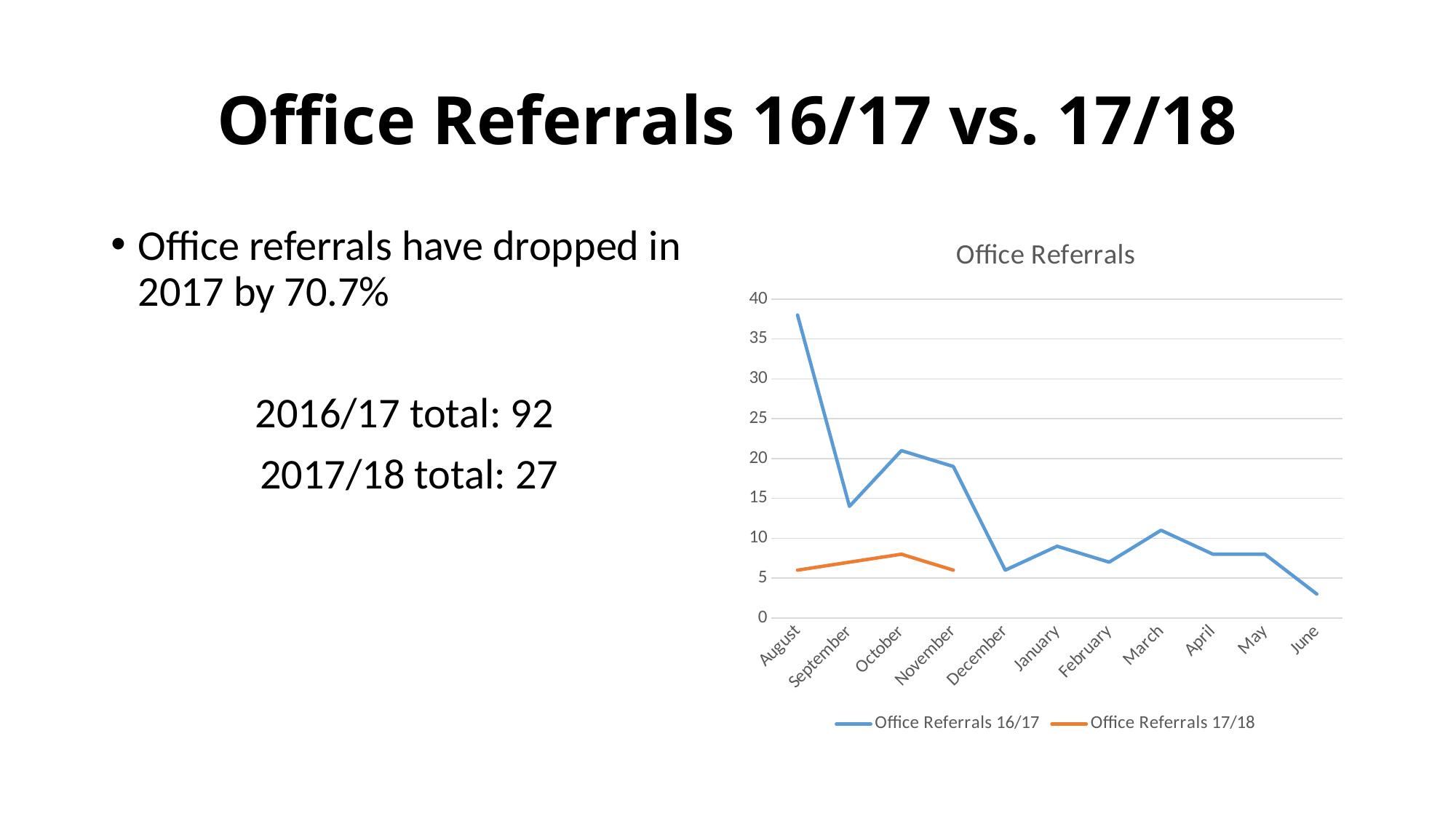
Is the value for June in the Office Referrals 16/17 series greater or less than 5? less In which month is the Office Referrals 16/17 series at its lowest? June How many series does the chart's legend list? 2 In which month is the Office Referrals 16/17 series at its highest? August Does the Office Referrals 16/17 series generally rise or fall from August to June? Fall Is the value for October in the Office Referrals 17/18 series greater or less than 10? less Is the value for August in the Office Referrals 16/17 series greater or less than 30? greater Which is larger for August: the Office Referrals 16/17 value or the Office Referrals 17/18 value? Office Referrals 16/17 How many months are shown along the x axis of the chart? 11 What is the title of the chart? Office Referrals What kind of chart is shown on the slide? Line chart